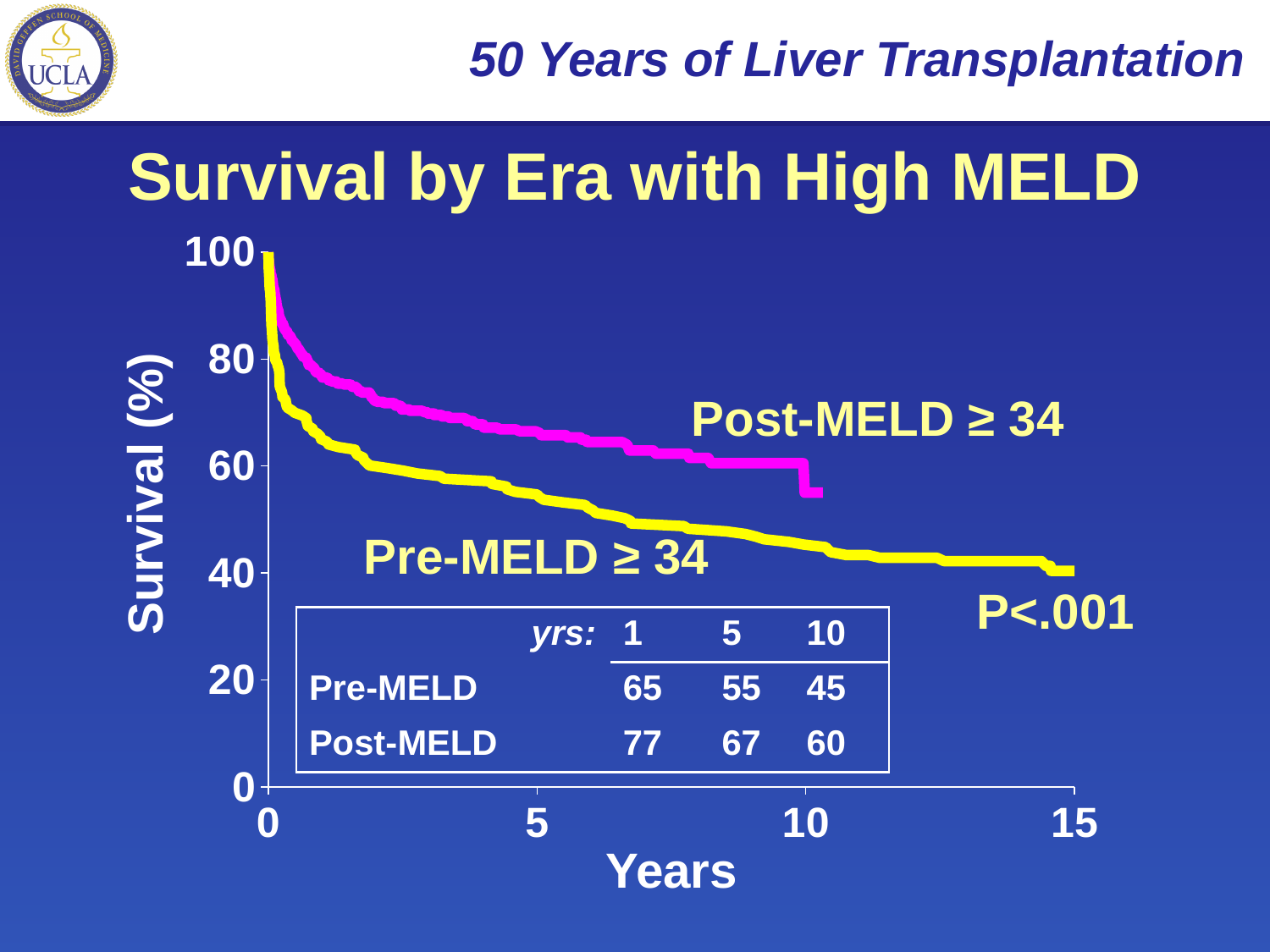
How many survival curves are plotted on the chart? 2 What is the difference between the Post-MELD and Pre-MELD 1-year survival values in the inset table? 12 According to the inset table, what is the 1-year survival for the Pre-MELD group? 65 What is the title of the chart? Survival by Era with High MELD Does survival rise or fall as years increase for the Pre-MELD ≥ 34 curve? fall What kind of chart is shown on the slide? line chart According to the inset table, what is the 10-year survival for the Post-MELD group? 60 Is the Pre-MELD ≥ 34 survival at 15 years greater or less than 60? less Which group has the higher 5-year survival, Pre-MELD or Post-MELD? Post-MELD What is the difference between the Post-MELD and Pre-MELD 10-year survival values in the inset table? 15 What p-value is shown on the chart for the comparison between the two curves? P<.001 According to the inset table, what is the 5-year survival for the Pre-MELD group? 55